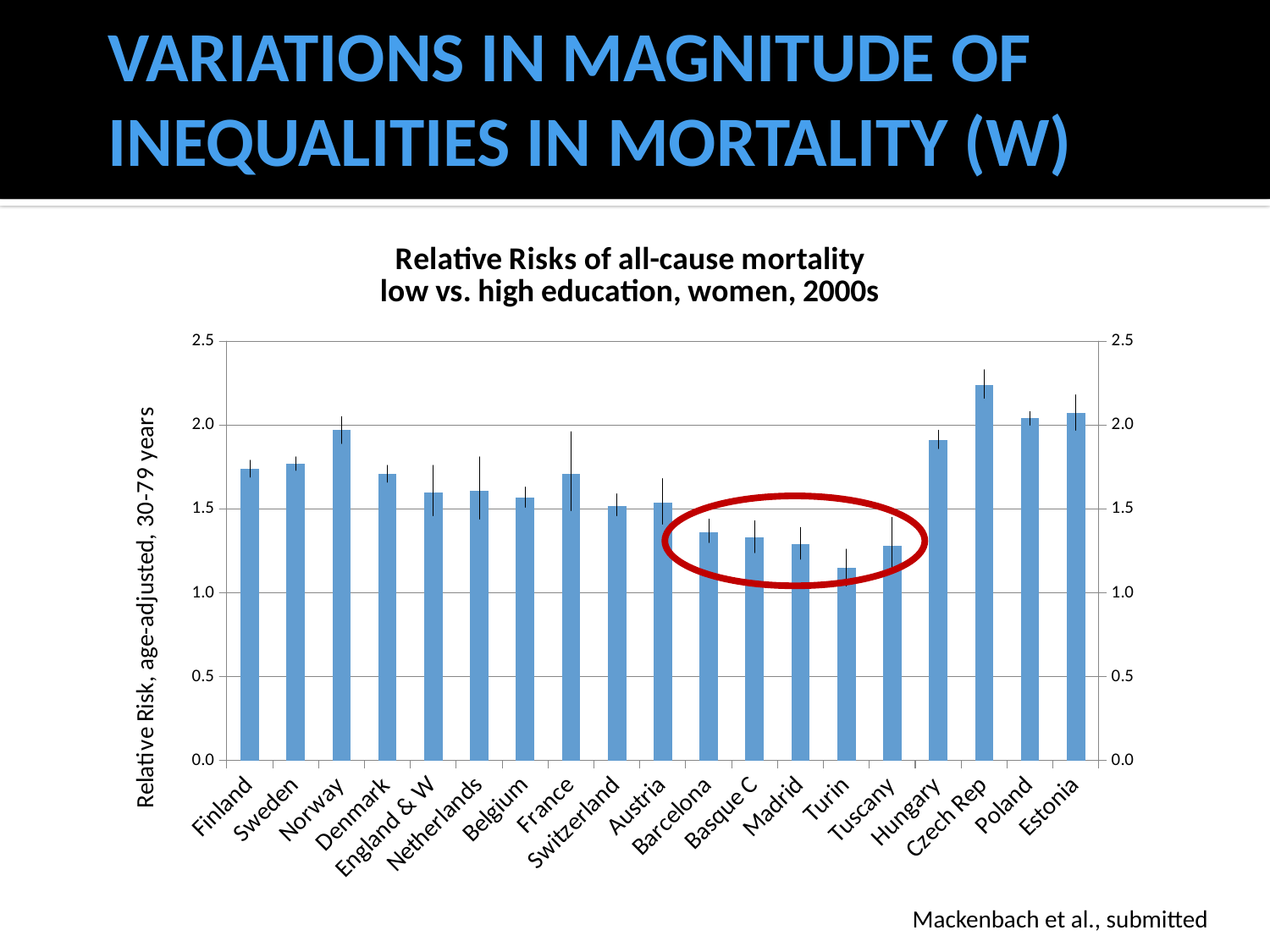
How many countries or regions are plotted on the x axis of the chart? 19 Which has the larger relative risk, Norway or Austria? Norway Which has the larger relative risk, Turin or Hungary? Hungary Which country or region has the lowest relative risk in the chart? Turin Is the value for Czech Rep greater or less than 2.0? greater What is the label on the vertical axis of the chart? Relative Risk, age-adjusted, 30-79 years What is the title of the chart? Relative Risks of all-cause mortality low vs. high education, women, 2000s Is the value for Turin greater or less than 1.5? less Which country or region has the highest relative risk in the chart? Czech Rep Is the value for Barcelona greater or less than 1.5? less What kind of chart is shown on the slide? bar chart